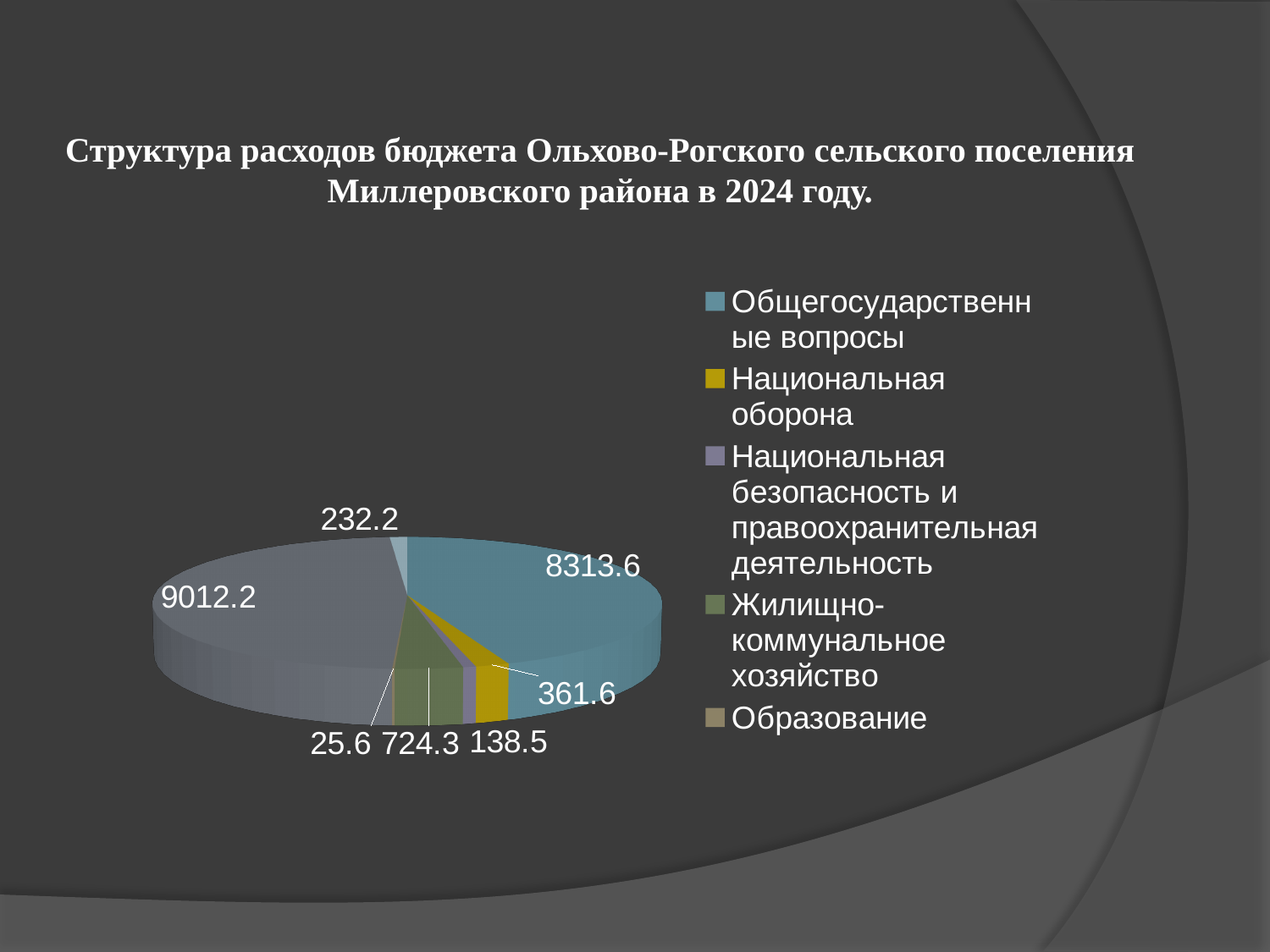
What is the value for Образование? 25.6 What is the value for Жилищно-коммунальное хозяйство? 724.3 How many entries does the legend list? 5 What is the value for Общегосударственные вопросы? 8313.6 What type of chart is shown on the slide? pie chart What is the difference between the values for Общегосударственные вопросы and Национальная оборона? 7952.0 What is the value for Национальная оборона? 361.6 Which is larger: Жилищно-коммунальное хозяйство or Национальная оборона? Жилищно-коммунальное хозяйство Which legend category has the smallest value? Образование What is the value for Национальная безопасность и правоохранительная деятельность? 138.5 What is the largest value labelled on the pie chart? 9012.2 How many slices does the pie chart have? 7